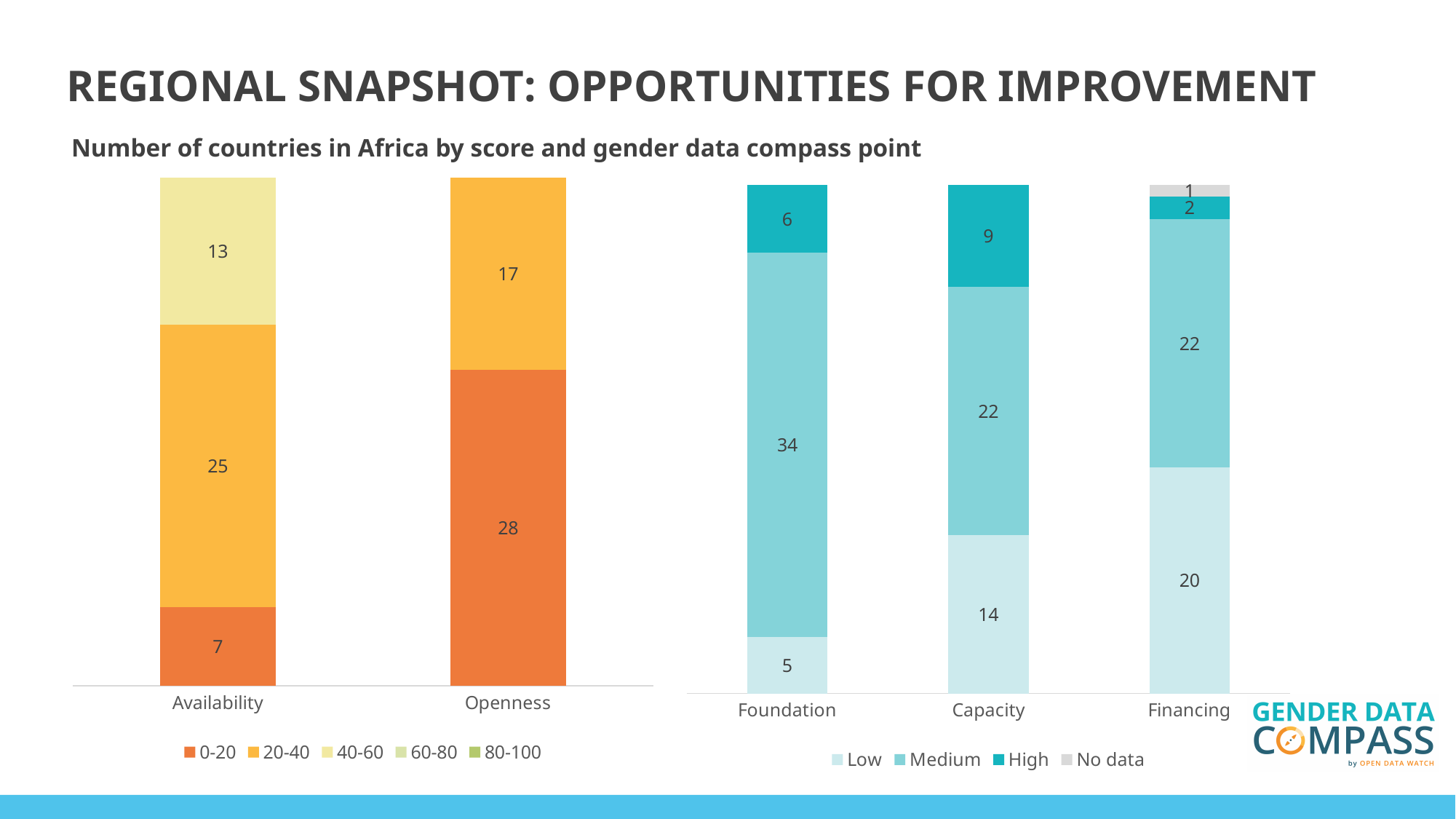
In the left chart, how many series does the legend list? 5 In the left chart, what is the difference between the 0-20 values for Openness and Availability? 21 In the right chart, which compass point has the lowest number of countries scoring Low? Foundation In the right chart, how many countries score Medium on Foundation? 34 In the right chart, how many categories are shown on the x axis? 3 In the right chart, how many countries score Low on Financing? 20 What kind of chart is the right chart? Stacked bar chart In the right chart, which compass point has the highest number of countries scoring High? Capacity In the right chart, what is the difference between the Low values for Financing and Capacity? 6 In the left chart, how many countries have an Availability score of 20-40? 25 In the left chart, how many countries have an Openness score of 0-20? 28 In the left chart, what is the total number of countries in the Availability bar? 45